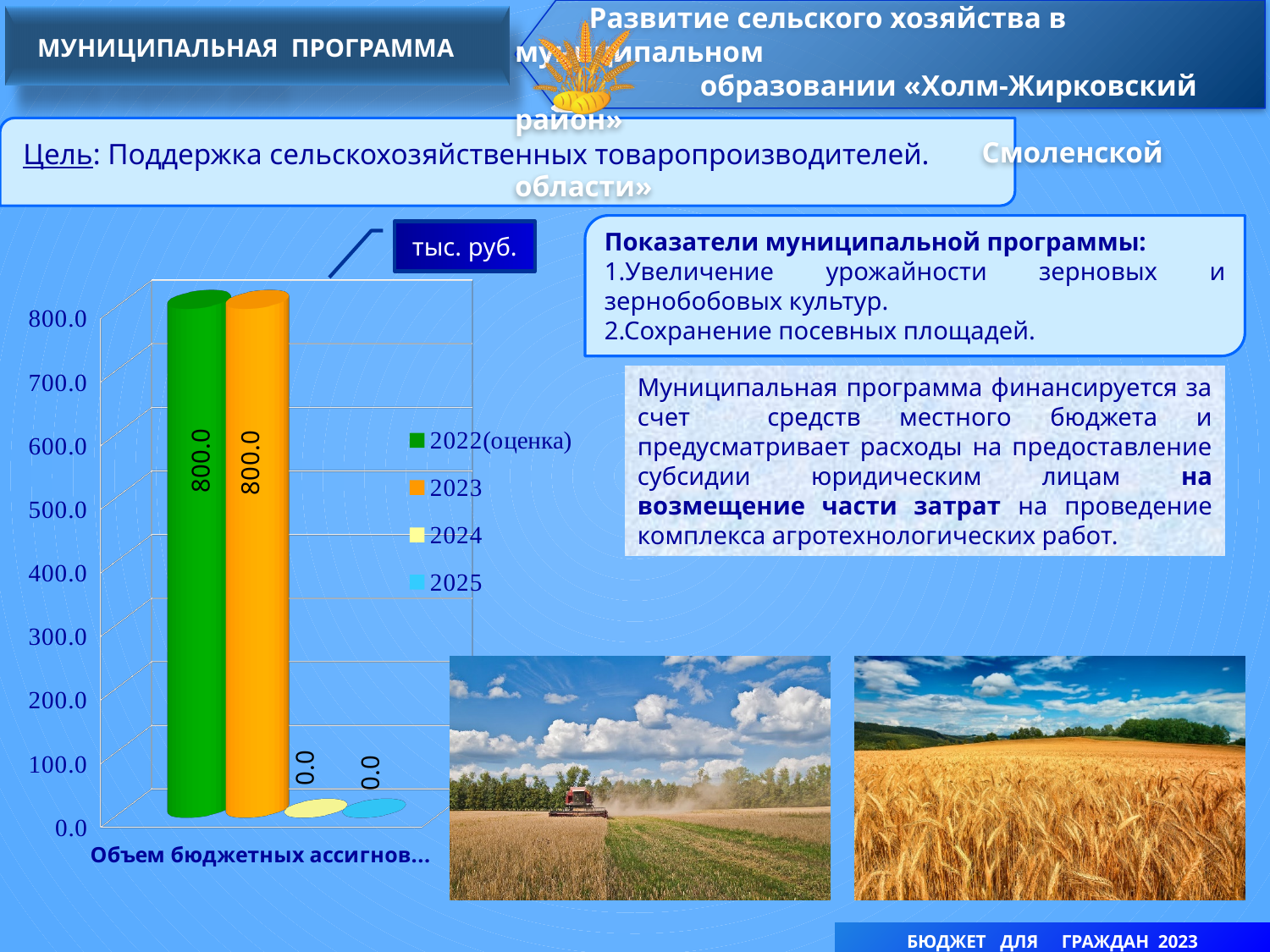
What is the value for the 2025 series on the chart? 0.0 How many series does the chart legend list? 4 What colour is the bar for the 2023 series? Orange Which is larger, the value for 2022(оценка) or the value for 2025? 2022(оценка) What kind of chart is shown on the slide? Bar chart What unit is shown in the box above the chart? тыс. руб. What is the value for the 2023 series on the chart? 800.0 What is the difference between the values for 2023 and 2024? 800.0 What is the value for the 2022(оценка) series on the chart? 800.0 What is the value for the 2024 series on the chart? 0.0 What is the highest value shown on the chart's vertical axis? 800.0 Is the value for 2023 greater or less than 500.0? greater